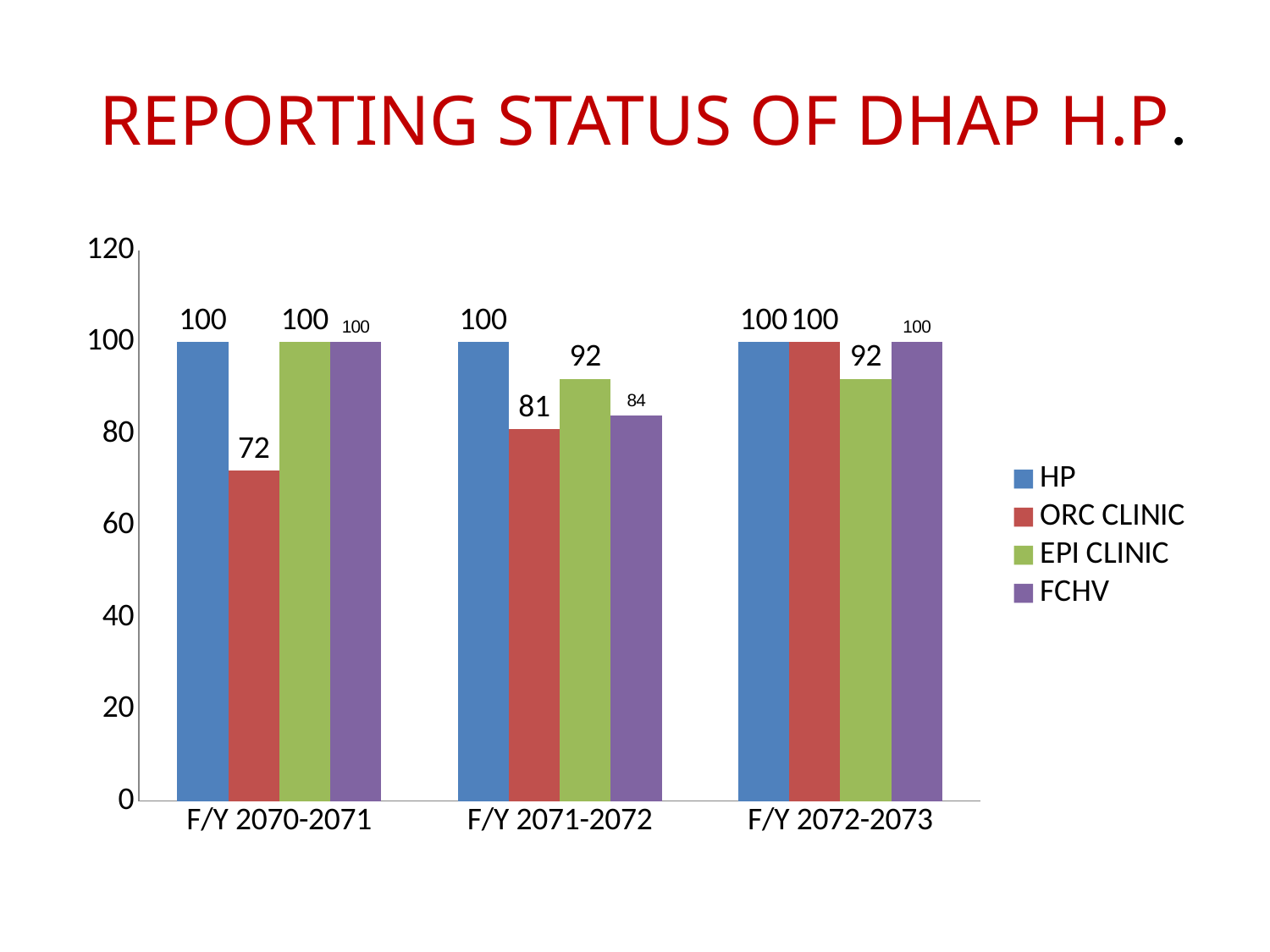
Which series has the lowest value in F/Y 2072-2073? EPI CLINIC Do the ORC CLINIC values rise or fall from F/Y 2070-2071 to F/Y 2072-2073? Rise What is the value for ORC CLINIC in F/Y 2070-2071? 72 What is the value for ORC CLINIC in F/Y 2071-2072? 81 What kind of chart is shown on the slide? Bar chart What is the value for FCHV in F/Y 2071-2072? 84 Which series has the lowest value in F/Y 2071-2072? ORC CLINIC What is the value for EPI CLINIC in F/Y 2072-2073? 92 What is the difference between the HP value and the ORC CLINIC value in F/Y 2070-2071? 28 Which is larger in F/Y 2071-2072, the EPI CLINIC value or the FCHV value? EPI CLINIC How many fiscal year categories are shown on the x axis? 3 How many series does the legend list? 4